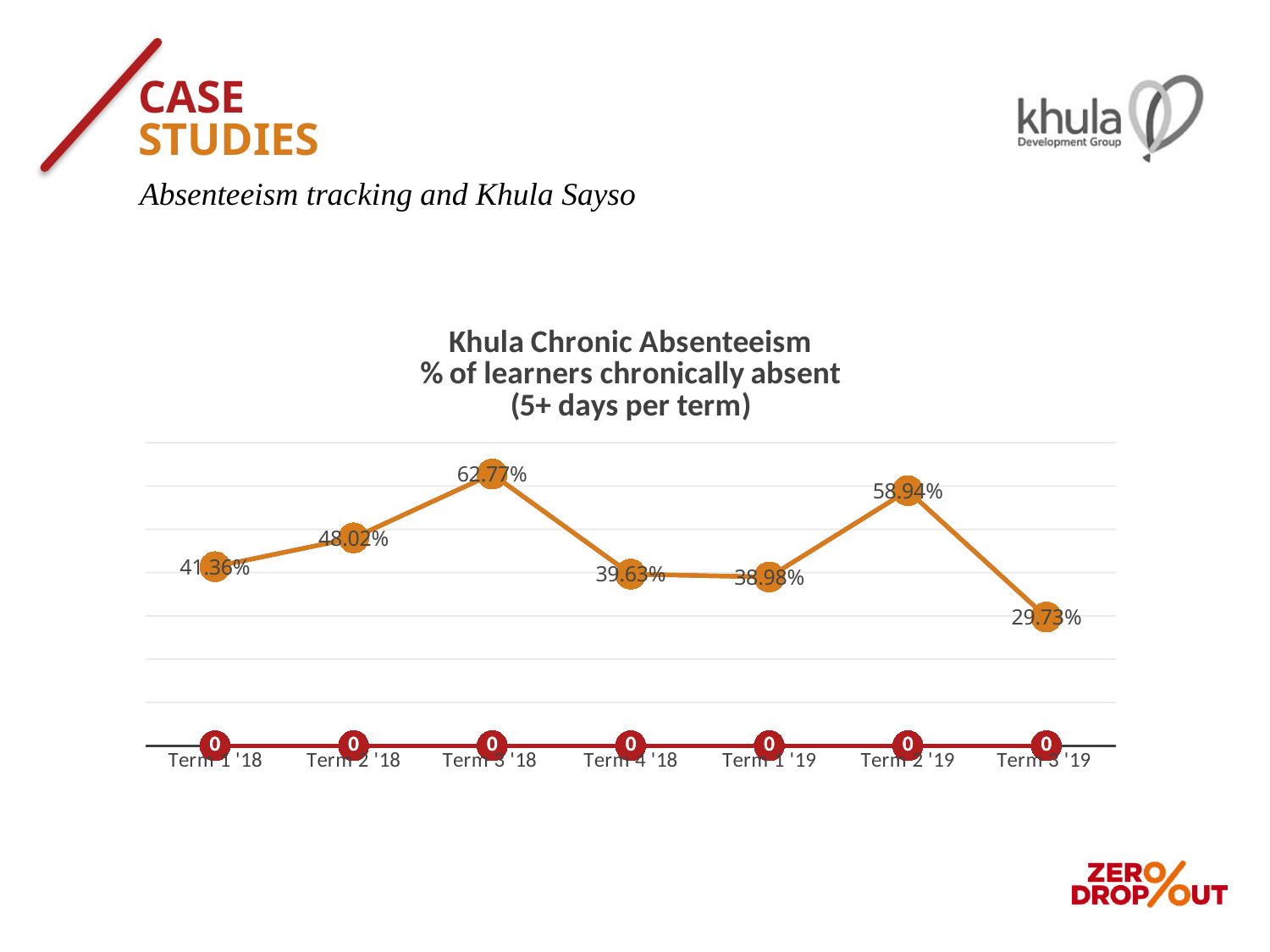
What is the value for Term 3 '18 in the Khula Chronic Absenteeism chart? 62.77% What is the value shown for Term 2 '19? 58.94% What is the difference between the values for Term 2 '19 and Term 3 '19? 29.21% How many terms are shown on the x axis of the chart? 7 Which term has the lowest percentage of learners chronically absent? Term 3 '19 What percentage of learners were chronically absent in Term 1 '19? 38.98% What is the value shown for Term 3 '19? 29.73% Does the percentage of learners chronically absent rise or fall from Term 2 '19 to Term 3 '19? Fall Which term has the highest percentage of learners chronically absent? Term 3 '18 What is the difference between the values for Term 3 '18 and Term 4 '18? 23.14% Which is larger, the value for Term 2 '18 or the value for Term 1 '18? Term 2 '18 What kind of chart is shown on the slide? Line chart